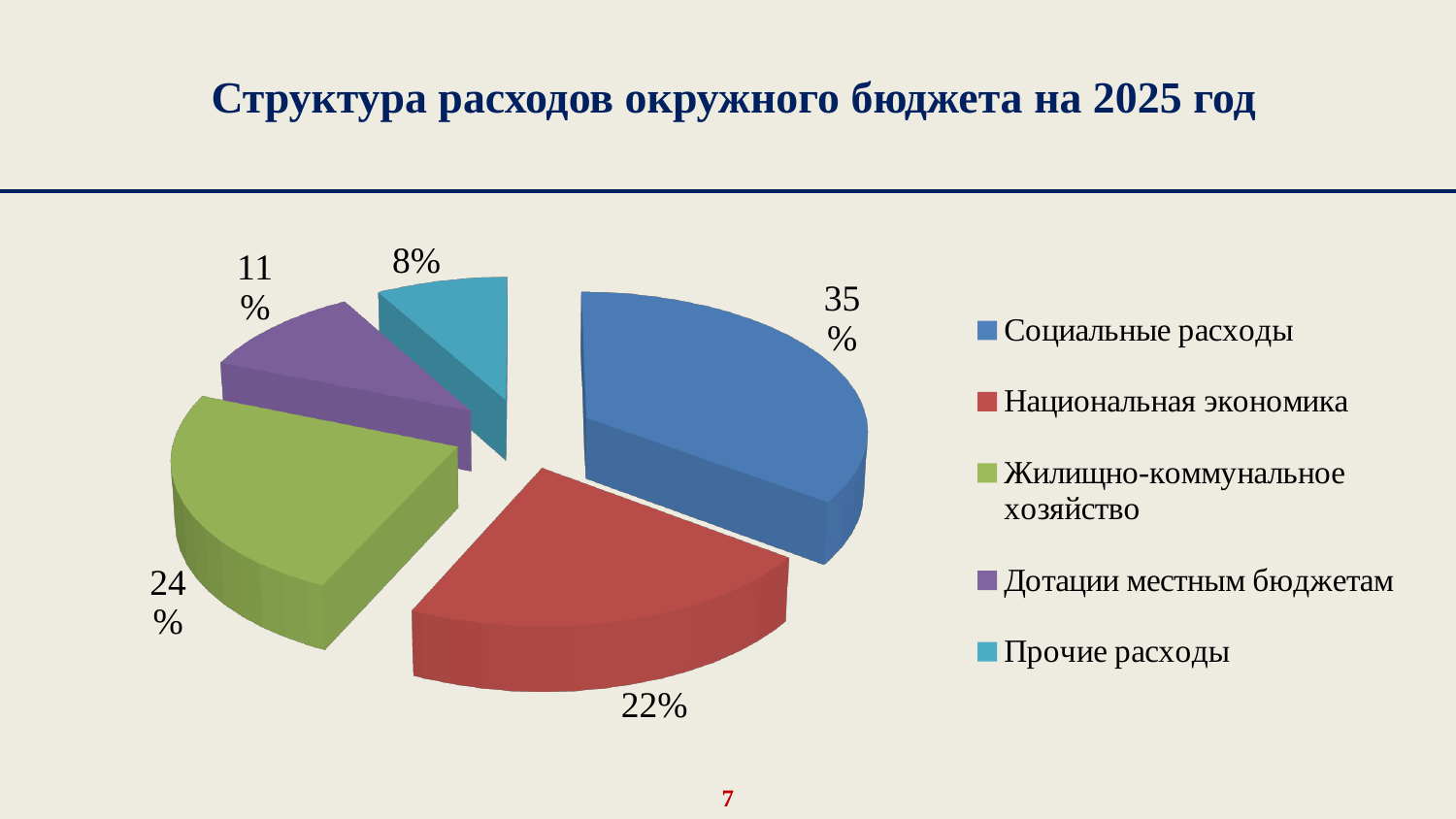
What share of the pie does Национальная экономика have? 22% Which category has the smallest share of the pie? Прочие расходы What share of the pie does Жилищно-коммунальное хозяйство have? 24% What type of chart is shown on the slide? Pie chart How many categories does the legend list? 5 What is the difference between the shares of Социальные расходы and Национальная экономика? 13% What share of the pie does Социальные расходы have? 35% What is the title of the chart on the slide? Структура расходов окружного бюджета на 2025 год Which category has the largest share of the pie? Социальные расходы Which is larger: the share of Жилищно-коммунальное хозяйство or the share of Национальная экономика? Жилищно-коммунальное хозяйство